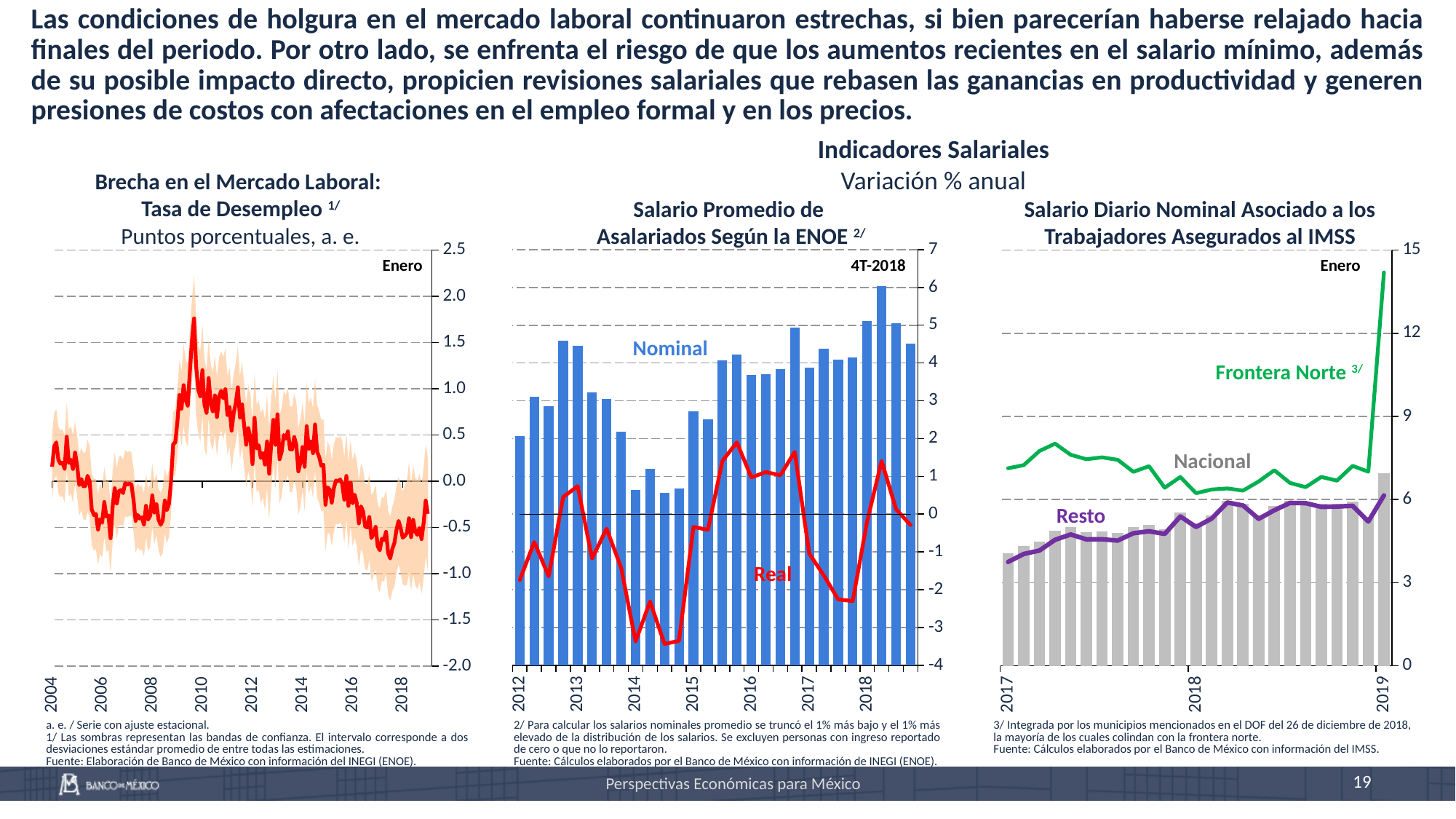
In the chart titled 'Brecha en el Mercado Laboral: Tasa de Desempleo', is the peak value reached around 2009-2010 greater or less than 1.5? greater In the chart titled 'Brecha en el Mercado Laboral: Tasa de Desempleo', what is the label of the last observation shown? Enero In the chart titled 'Salario Promedio de Asalariados Según la ENOE', what is the label of the last period shown? 4T-2018 In the chart titled 'Brecha en el Mercado Laboral: Tasa de Desempleo', what kind of chart is used to show the data? line chart In the chart titled 'Salario Diario Nominal Asociado a los Trabajadores Asegurados al IMSS', which series is higher at the end of the period, Frontera Norte or Nacional? Frontera Norte In the chart titled 'Brecha en el Mercado Laboral: Tasa de Desempleo', is the value in 2017 greater or less than 0.0? less In the chart titled 'Salario Diario Nominal Asociado a los Trabajadores Asegurados al IMSS', is the first value of the Resto series (2017) greater or less than 6? less In the chart titled 'Salario Promedio de Asalariados Según la ENOE', which two series are labelled on the chart? Nominal and Real In the chart titled 'Salario Diario Nominal Asociado a los Trabajadores Asegurados al IMSS', does the Resto series generally rise or fall from 2017 to 2019? rise